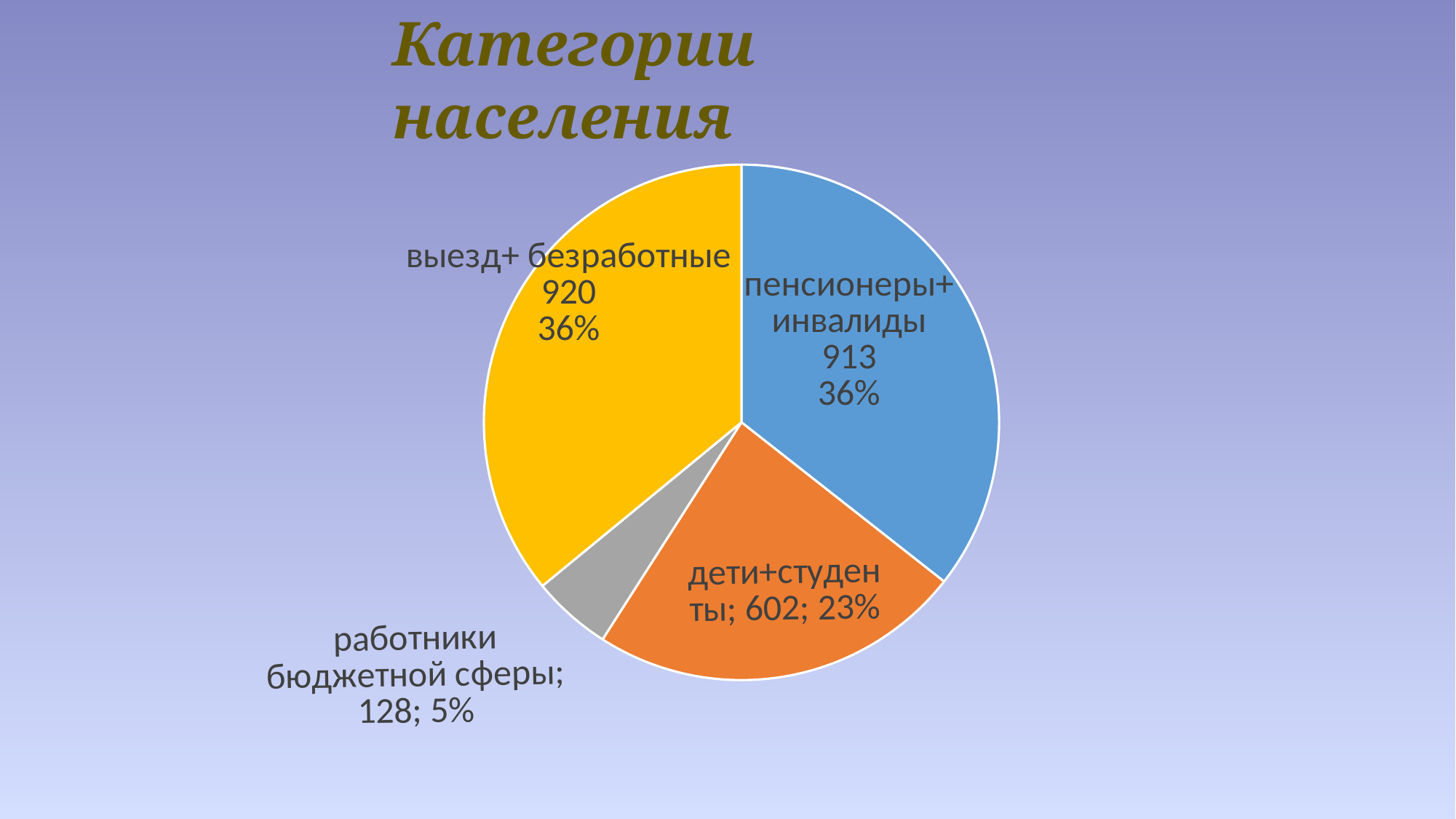
Which category has the smallest value? работники бюджетной сферы What is the value for работники бюджетной сферы? 128 What kind of chart is shown on the slide? pie chart What is the value for пенсионеры+инвалиды? 913 How many categories (slices) does the pie chart have? 4 What is the value for дети+студенты? 602 What is the difference between the values for пенсионеры+инвалиды and дети+студенты? 311 What share of the pie does дети+студенты represent? 23% What is the title of the chart? Категории населения What share of the pie does работники бюджетной сферы represent? 5% Which category has the largest value? выезд+безработные What is the value for выезд+безработные? 920